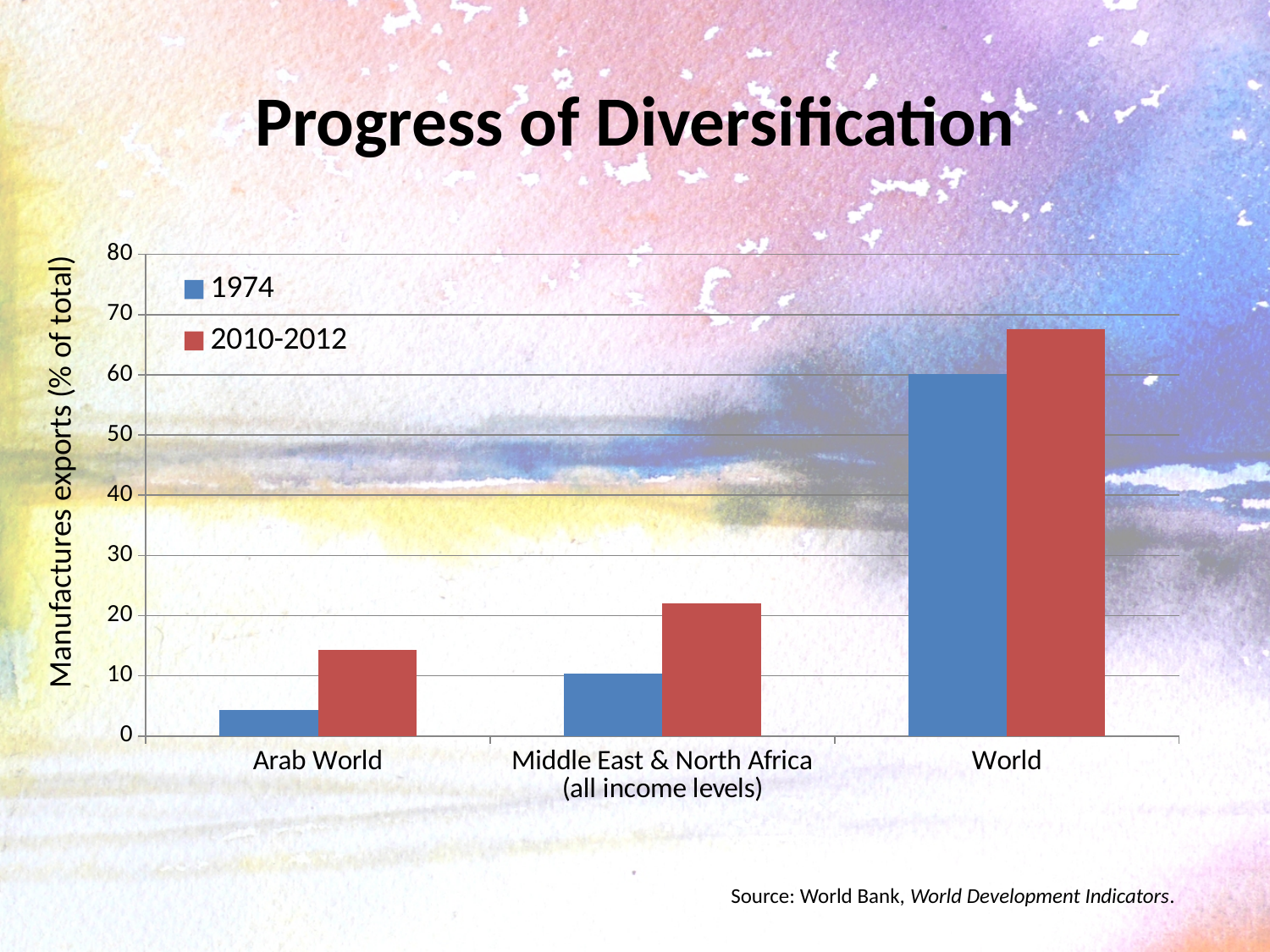
What is the label on the vertical axis of the chart? Manufactures exports (% of total) Is the value for Arab World in 1974 greater or less than 10? less Is the value for Arab World in 2010-2012 greater or less than 10? greater For the World category, which is larger: the 1974 value or the 2010-2012 value? 2010-2012 Do the 2010-2012 values rise or fall moving from Arab World to World along the x axis? rise Which category has the highest value for the 2010-2012 series? World Is the value for World in 2010-2012 greater or less than 60? greater How many categories are shown on the x axis? 3 Which category has the lowest value for the 1974 series? Arab World How many series does the legend list? 2 What kind of chart is shown on the slide? bar chart